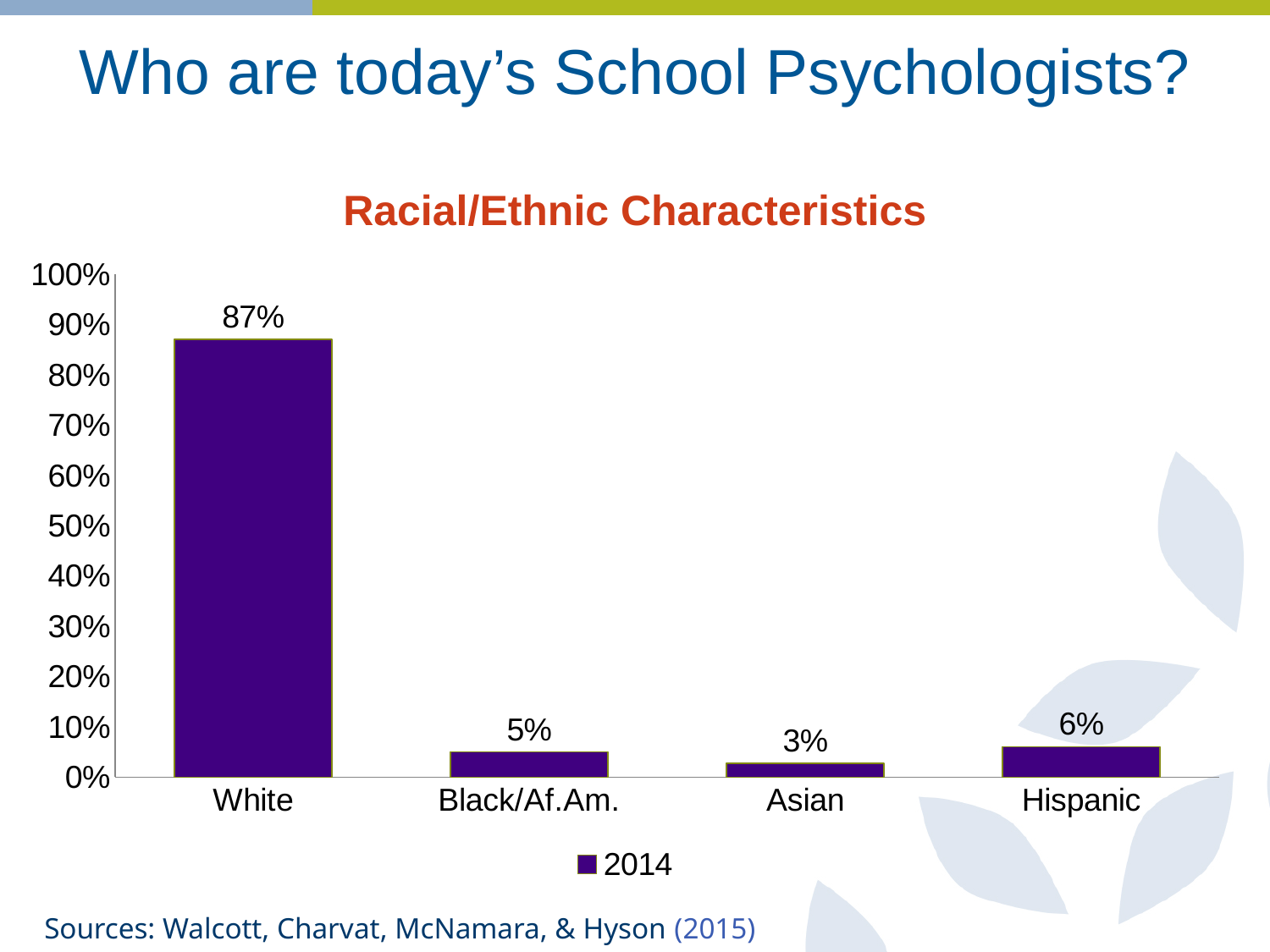
What is the difference between the values for Hispanic and Asian? 3% What is the value for Asian? 3% What is the value for Black/Af.Am.? 5% What series does the legend list? 2014 Which category has the lowest value? Asian What kind of chart is shown on the slide? Bar chart Which is larger, the value for Black/Af.Am. or the value for Hispanic? Hispanic What is the value for Hispanic? 6% What is the difference between the values for White and Hispanic? 81% How many categories are shown on the x axis? 4 Which category has the highest value? White What is the value for White? 87%